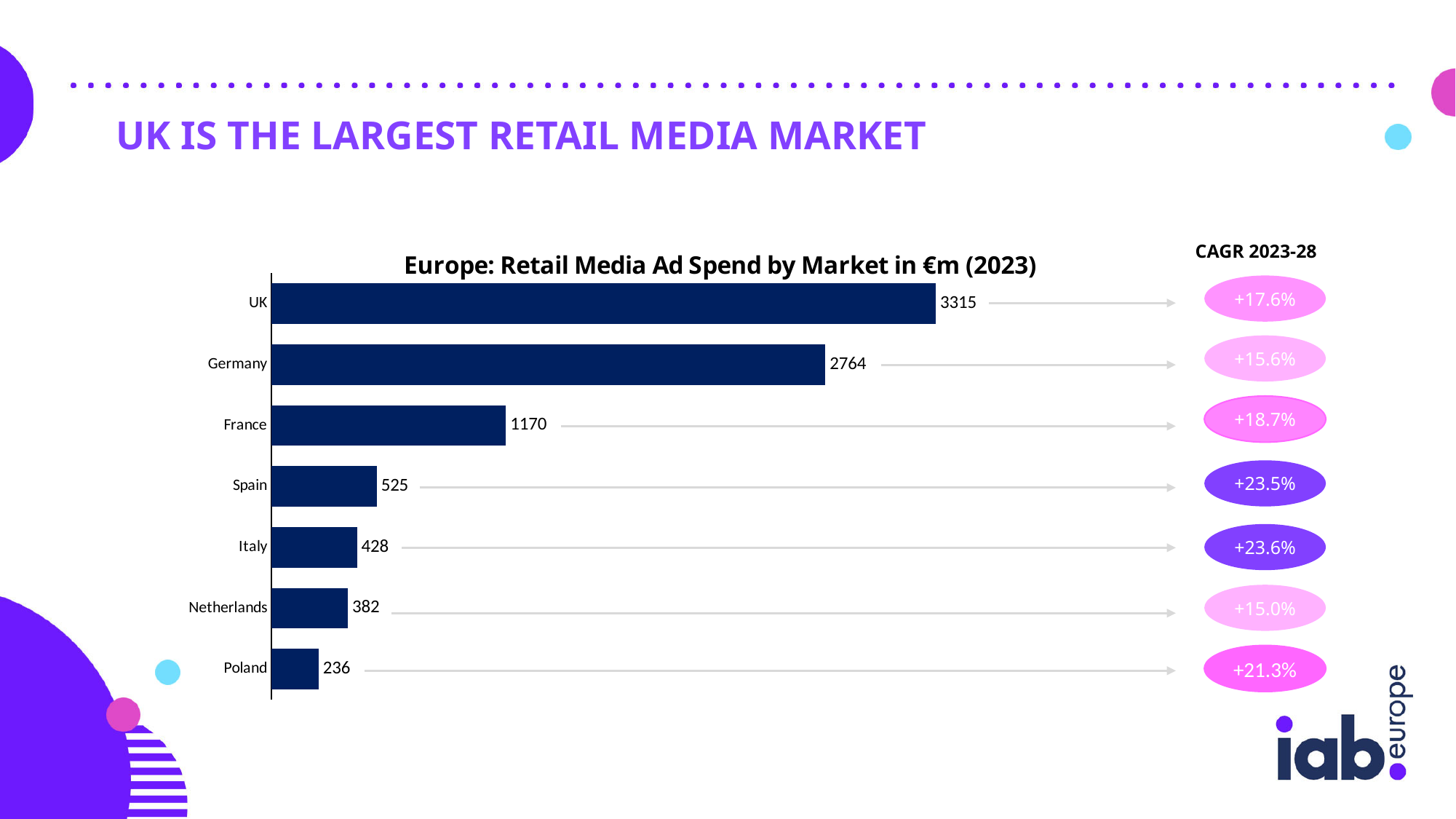
What kind of chart is shown on the slide? Bar chart What is the difference in retail media ad spend between the UK and Germany? 551 What is the retail media ad spend value for Netherlands? 382 Which market has the highest retail media ad spend? UK How many markets are shown in the chart? 7 What is the retail media ad spend value for Spain? 525 What is the difference in retail media ad spend between Italy and Netherlands? 46 What is the title of the chart? Europe: Retail Media Ad Spend by Market in €m (2023) Which market has the lowest retail media ad spend? Poland What is the retail media ad spend value for Germany? 2764 Which has a larger retail media ad spend, France or Spain? France What is the CAGR 2023-28 shown for Italy? +23.6%